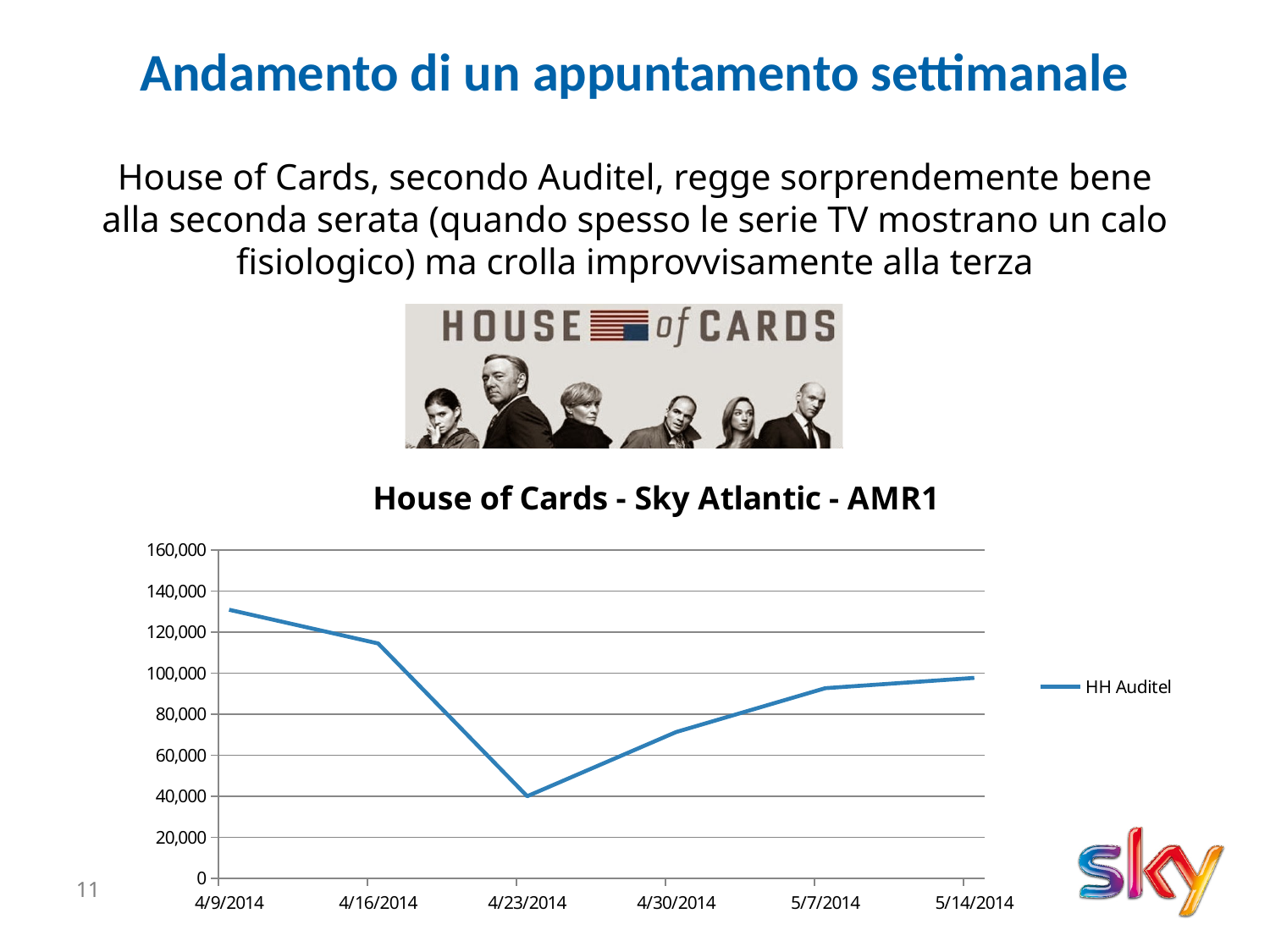
What is the name of the series shown in the legend? HH Auditel Is the value for 5/14/2014 greater or less than 100,000? less On which date is the HH Auditel value highest? 4/9/2014 Do the values rise or fall between 4/23/2014 and 5/14/2014? rise How many dates are plotted on the x axis? 6 How many series does the legend list? 1 What kind of chart is shown on the slide? line chart Which date has a larger value, 4/16/2014 or 4/30/2014? 4/16/2014 What is the title of the chart? House of Cards - Sky Atlantic - AMR1 Is the value for 4/9/2014 greater or less than 120,000? greater Is the value for 4/23/2014 greater or less than 60,000? less On which date is the HH Auditel value lowest? 4/23/2014